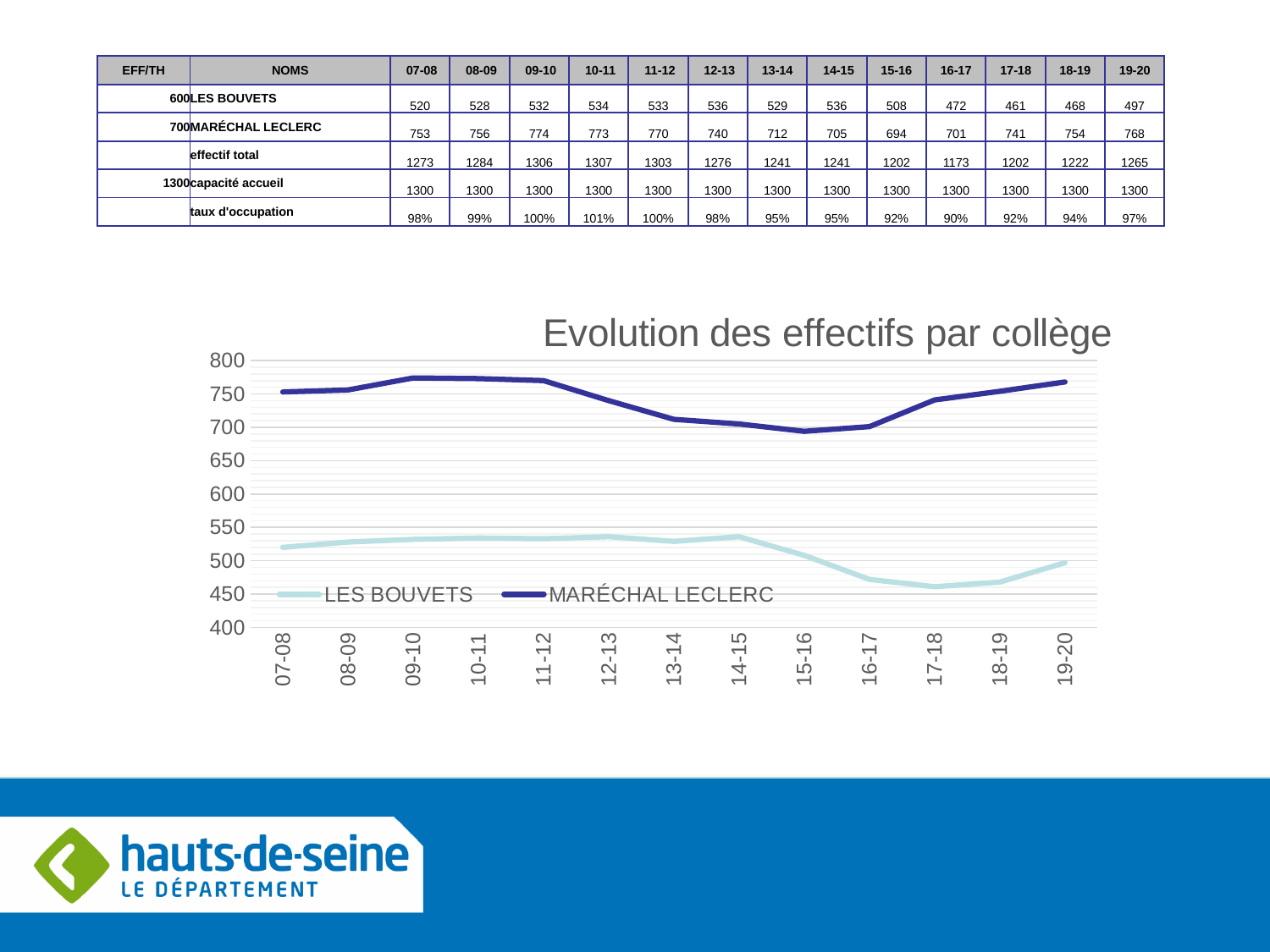
What kind of chart is shown on the slide? line chart According to the table, what is the value for LES BOUVETS in 07-08? 520 How many school years are plotted along the x axis of the chart? 13 Which two series are named in the chart legend? LES BOUVETS and MARÉCHAL LECLERC Is the value for MARÉCHAL LECLERC in 09-10 greater or less than 750? greater What is the title of the chart? Evolution des effectifs par collège Does the LES BOUVETS line rise or fall from 14-15 to 17-18? fall Using the values in the table, what is the difference between MARÉCHAL LECLERC and LES BOUVETS in 07-08? 233 In 07-08, which series has the larger value, LES BOUVETS or MARÉCHAL LECLERC? MARÉCHAL LECLERC Is the value for LES BOUVETS in 16-17 greater or less than 500? less How many series does the chart legend list? 2 According to the table, what is the value for MARÉCHAL LECLERC in 19-20? 768